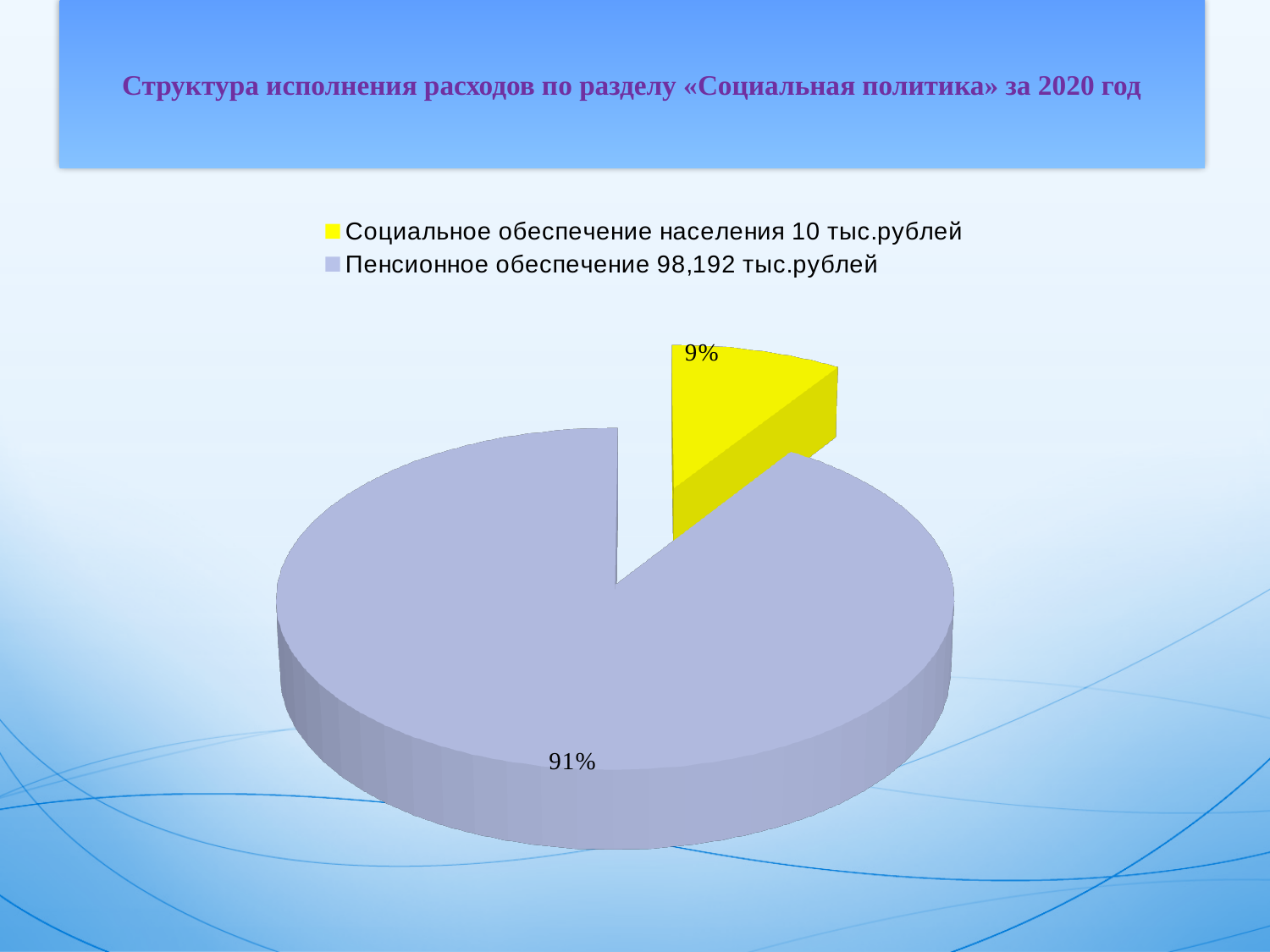
What kind of chart is shown on the slide? pie chart What amount in тыс.рублей does the legend give for "Пенсионное обеспечение"? 98,192 тыс.рублей What amount in тыс.рублей does the legend give for "Социальное обеспечение населения"? 10 тыс.рублей What colour is the slice for "Социальное обеспечение населения"? yellow How many entries does the legend list? 2 What is the difference in percentage points between the "Пенсионное обеспечение" slice and the "Социальное обеспечение населения" slice? 82 How many slices does the pie chart have? 2 Which category has the smallest slice of the pie? Социальное обеспечение населения Which category has the largest slice of the pie? Пенсионное обеспечение What share of the pie does "Пенсионное обеспечение" represent? 91% What share of the pie does "Социальное обеспечение населения" represent? 9% Which slice is larger: "Социальное обеспечение населения" or "Пенсионное обеспечение"? Пенсионное обеспечение